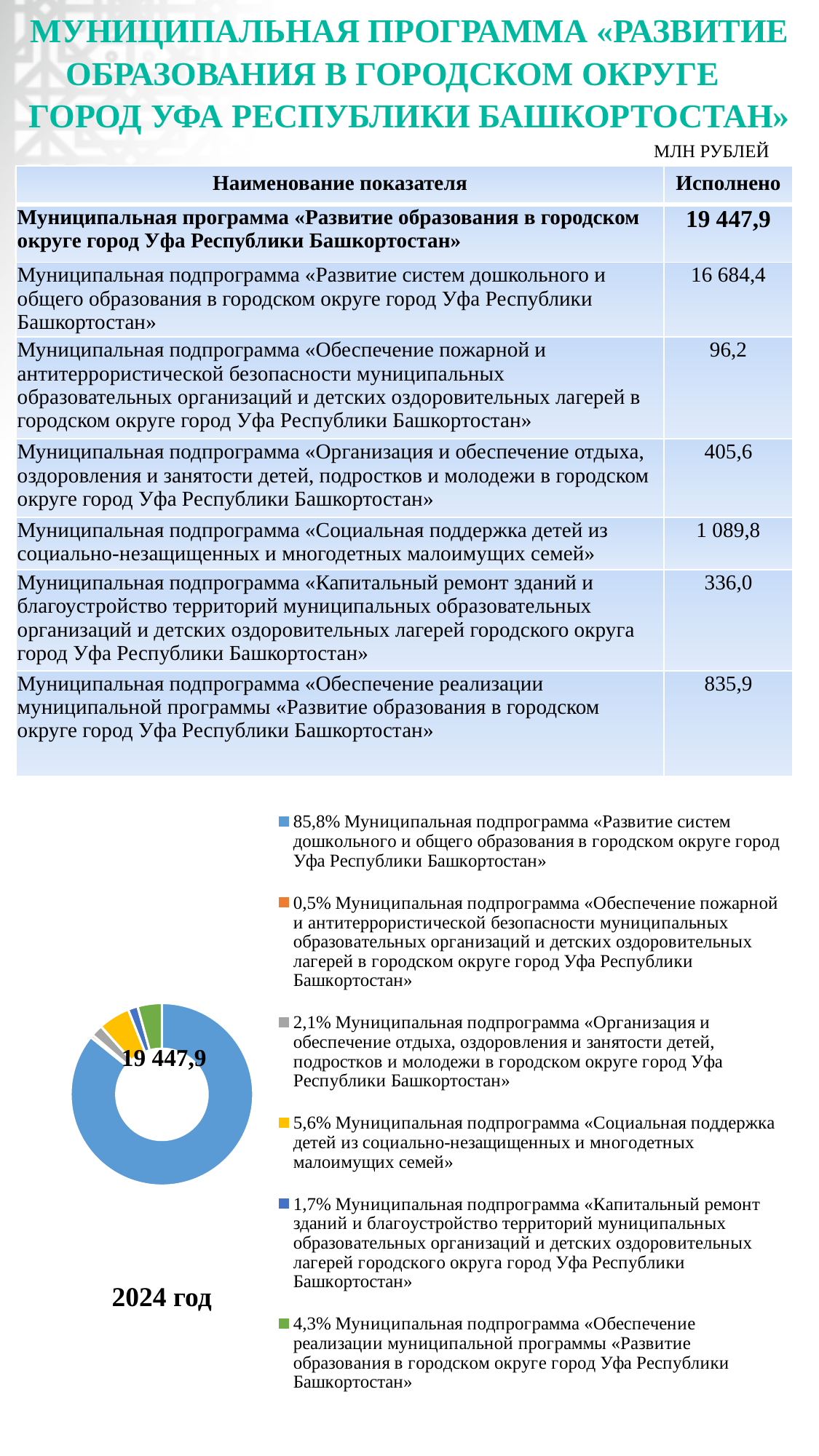
What is the difference in percentage points between the share of «Социальная поддержка детей...» and the share of «Организация и обеспечение отдыха...» in the doughnut chart? 3,5 percentage points What share of the doughnut chart does the subprogramme «Социальная поддержка детей из социально-незащищенных и многодетных малоимущих семей» take? 5,6% Which subprogramme has the largest slice in the doughnut chart? Муниципальная подпрограмма «Развитие систем дошкольного и общего образования в городском округе город Уфа Республики Башкортостан» What year is labelled under the doughnut chart? 2024 год What share of the doughnut chart does the subprogramme «Развитие систем дошкольного и общего образования в городском округе город Уфа Республики Башкортостан» take? 85,8% What share of the doughnut chart does the subprogramme «Организация и обеспечение отдыха, оздоровления и занятости детей, подростков и молодежи в городском округе город Уфа Республики Башкортостан» take? 2,1% In the doughnut chart, which slice is larger: «Капитальный ремонт зданий и благоустройство территорий...» (1,7%) or «Обеспечение реализации муниципальной программы...» (4,3%)? «Обеспечение реализации муниципальной программы...» (4,3%) What kind of chart is shown at the bottom of the slide? Doughnut (pie) chart What total value is printed in the centre of the doughnut chart? 19 447,9 How many slices does the doughnut chart have? 6